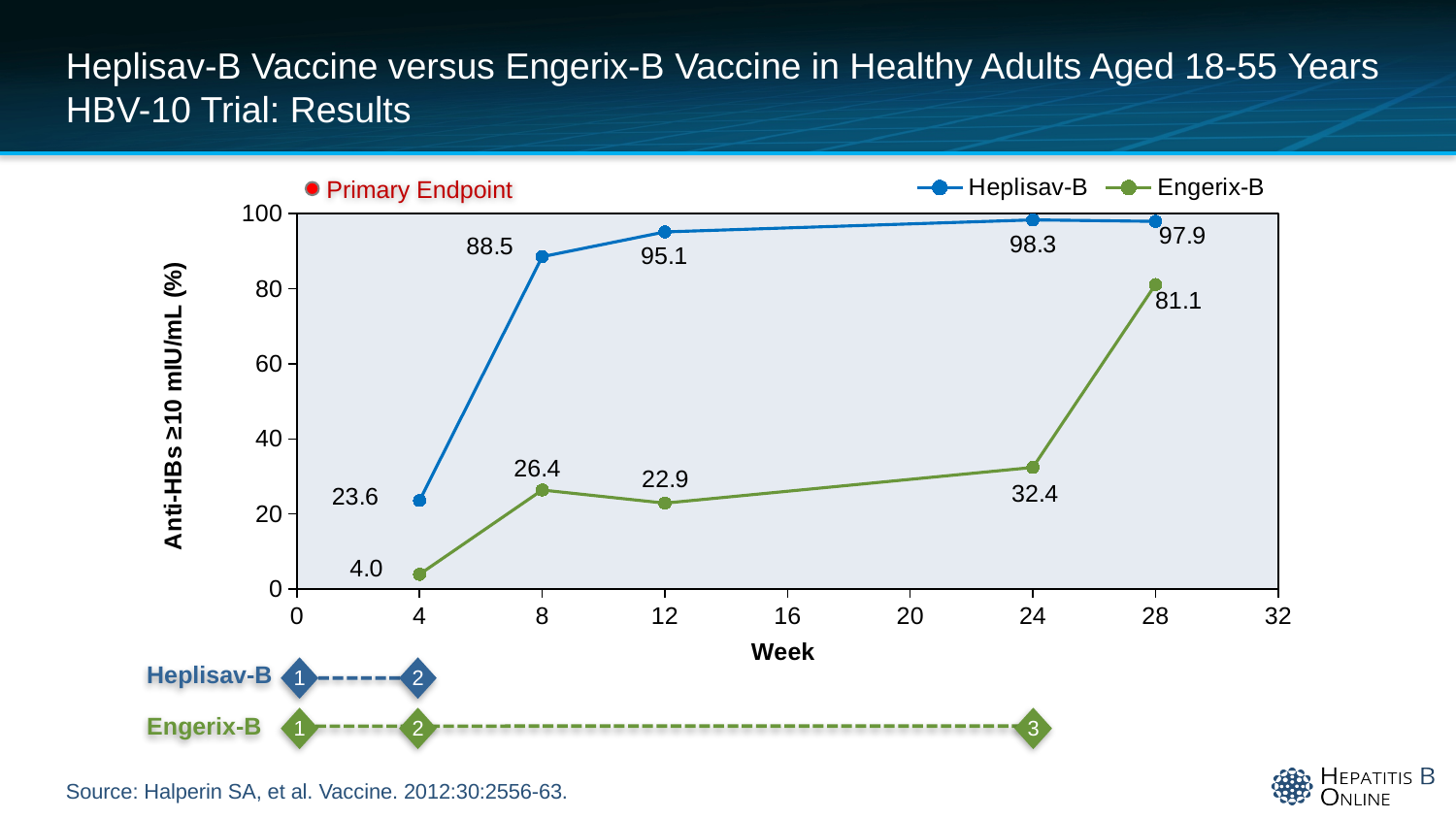
What is the label of the y axis? Anti-HBs ≥10 mIU/mL (%) At which week does the Heplisav-B series reach its highest value? 24 What is the difference between the Heplisav-B and Engerix-B values at week 12? 72.2 Which series has the higher value at week 28, Heplisav-B or Engerix-B? Heplisav-B How many data points are plotted for the Engerix-B series? 5 What kind of chart is shown on the slide? Line chart What is the Heplisav-B value at week 24? 98.3 What is the Heplisav-B value at week 8? 88.5 What is the Engerix-B value at week 4? 4.0 How many series does the legend list? 2 What is the Engerix-B value at week 28? 81.1 At which week is the Engerix-B value lowest? 4